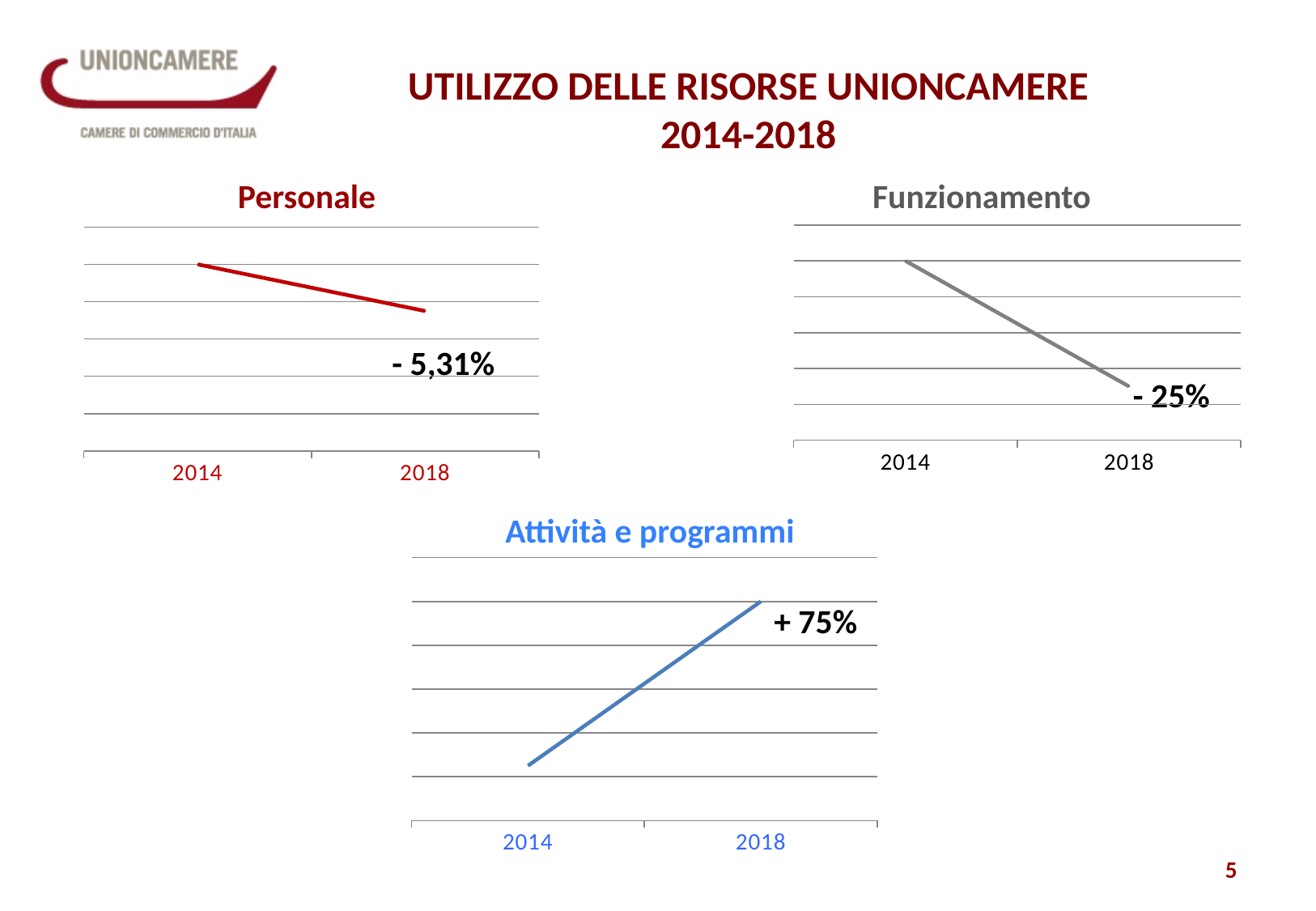
What is the title of the chart at the bottom of the slide? Attività e programmi How many points are plotted on the x axis of the 'Personale' chart? 2 In the 'Attività e programmi' chart, does the line rise or fall from 2014 to 2018? rise In the 'Personale' chart, does the line rise or fall from 2014 to 2018? fall What kind of chart is the 'Funzionamento' chart? line chart What are the two years shown on the x axis of the 'Attività e programmi' chart? 2014 and 2018 What percentage change is printed on the 'Personale' chart? - 5,31% How many charts are shown on the slide? 3 In the 'Funzionamento' chart, does the line rise or fall from 2014 to 2018? fall What percentage change is printed on the 'Attività e programmi' chart? + 75% What percentage change is printed on the 'Funzionamento' chart? - 25% What kind of chart is the 'Personale' chart? line chart